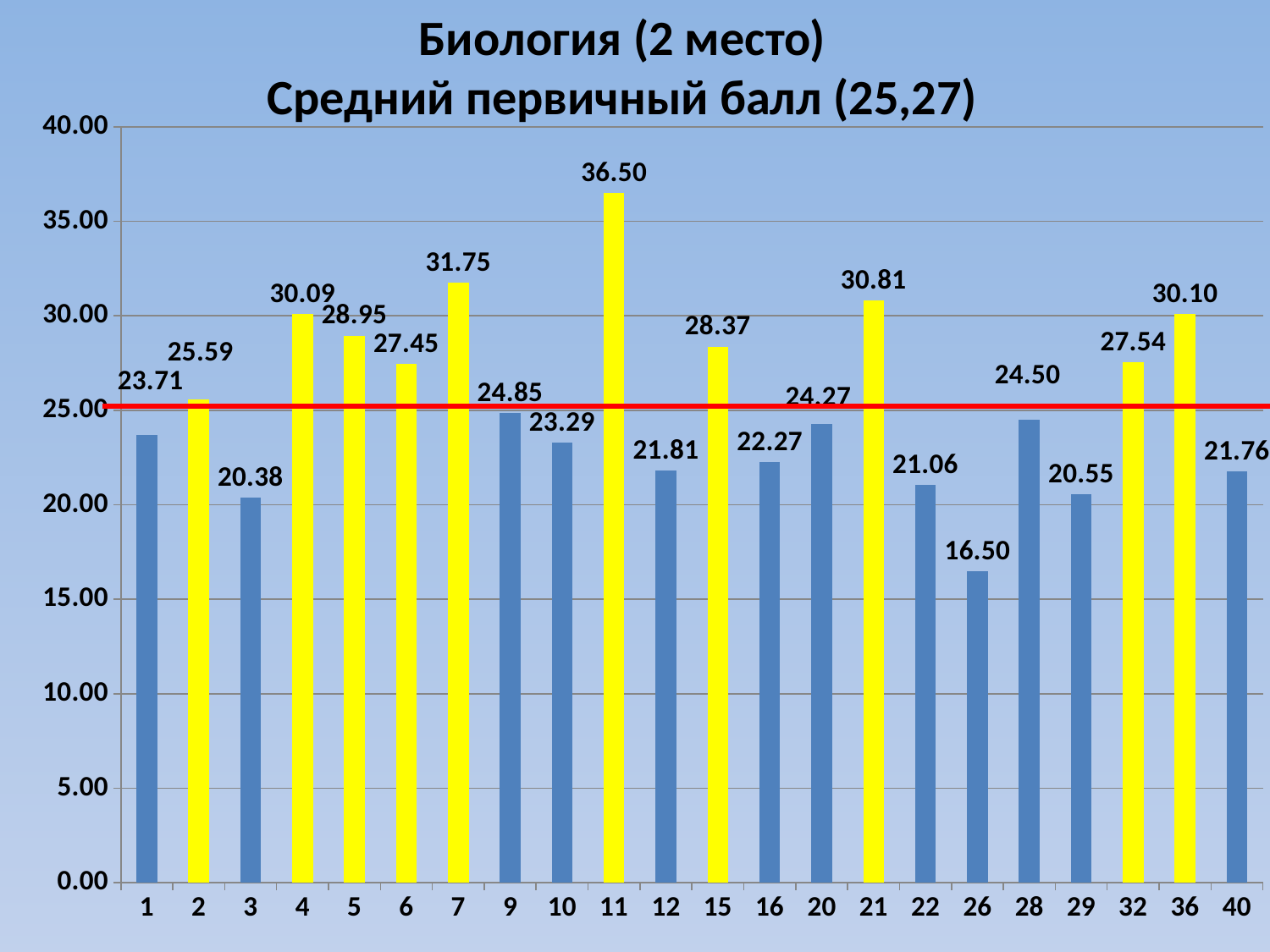
What is the value for category 11? 36.50 What value is given in parentheses in the chart title as the average primary score? 25,27 Which is larger, the value for category 21 or the value for category 22? 21 What is the difference between the values for category 7 and category 1? 8.04 Which category has the lowest value? 26 Which category has the highest value? 11 Is the value for category 3 greater or less than 25.00? less What kind of chart is shown on the slide? bar chart What is the difference between the values for category 11 and category 26? 20.00 How many categories are shown on the x axis? 22 What is the value for category 26? 16.50 What is the value for category 32? 27.54